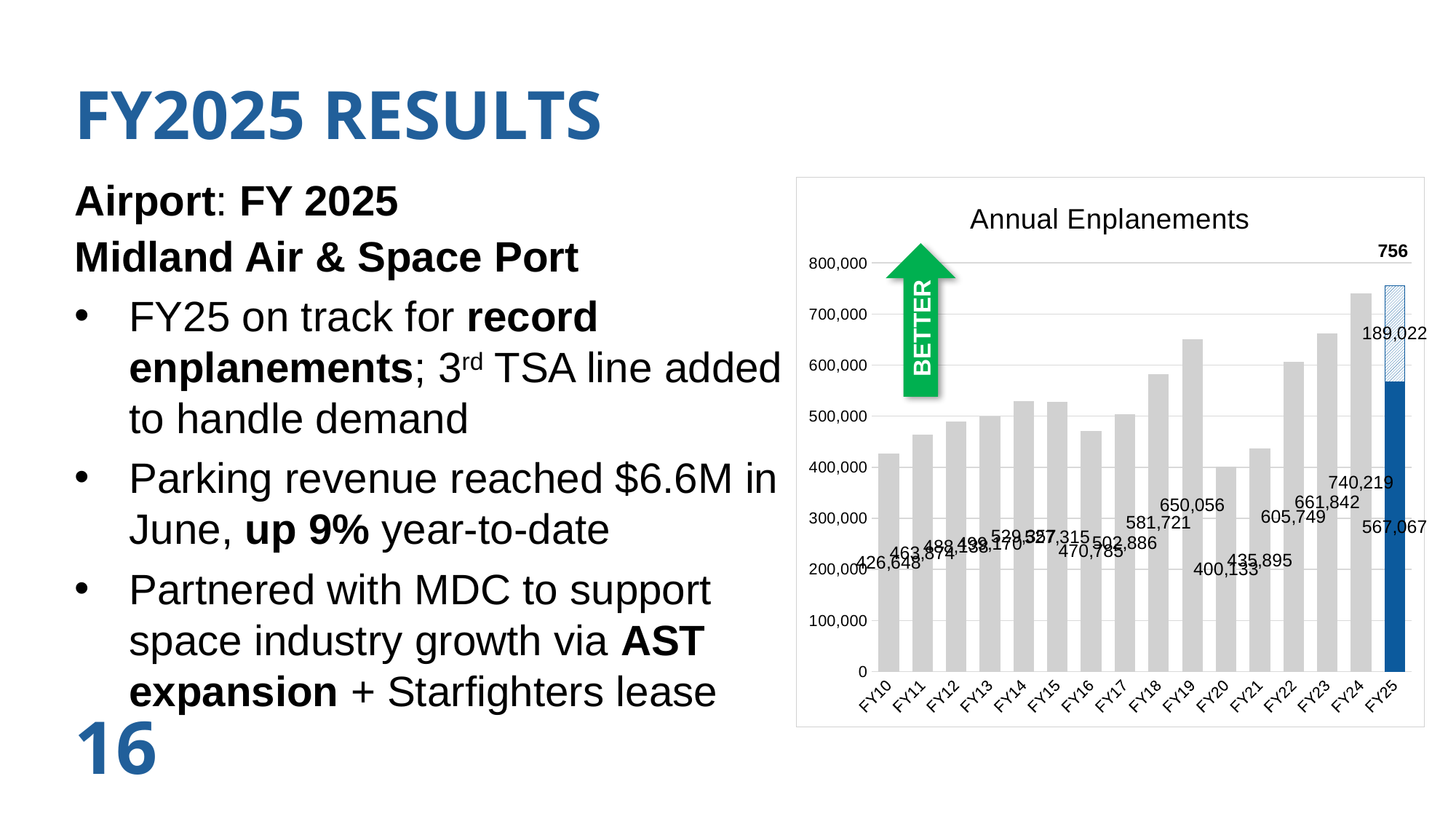
Which fiscal year has the lowest enplanements in the chart? FY20 What kind of chart is shown on the slide? bar chart What is the title of the chart? Annual Enplanements What is the value for FY24 in the Annual Enplanements chart? 740,219 Which is larger, the value for FY19 or the value for FY22? FY19 What is the difference between the FY24 and FY23 values? 78,377 How many fiscal years are shown on the x axis of the chart? 16 Among FY10 through FY24, which fiscal year has the highest enplanements? FY24 What is the total of the two stacked segments of the FY25 bar (567,067 and 189,022)? 756,089 What is the value for FY20 in the Annual Enplanements chart? 400,133 What is the value of the solid blue portion of the FY25 bar? 567,067 Is the value for FY16 greater or less than 500,000? less